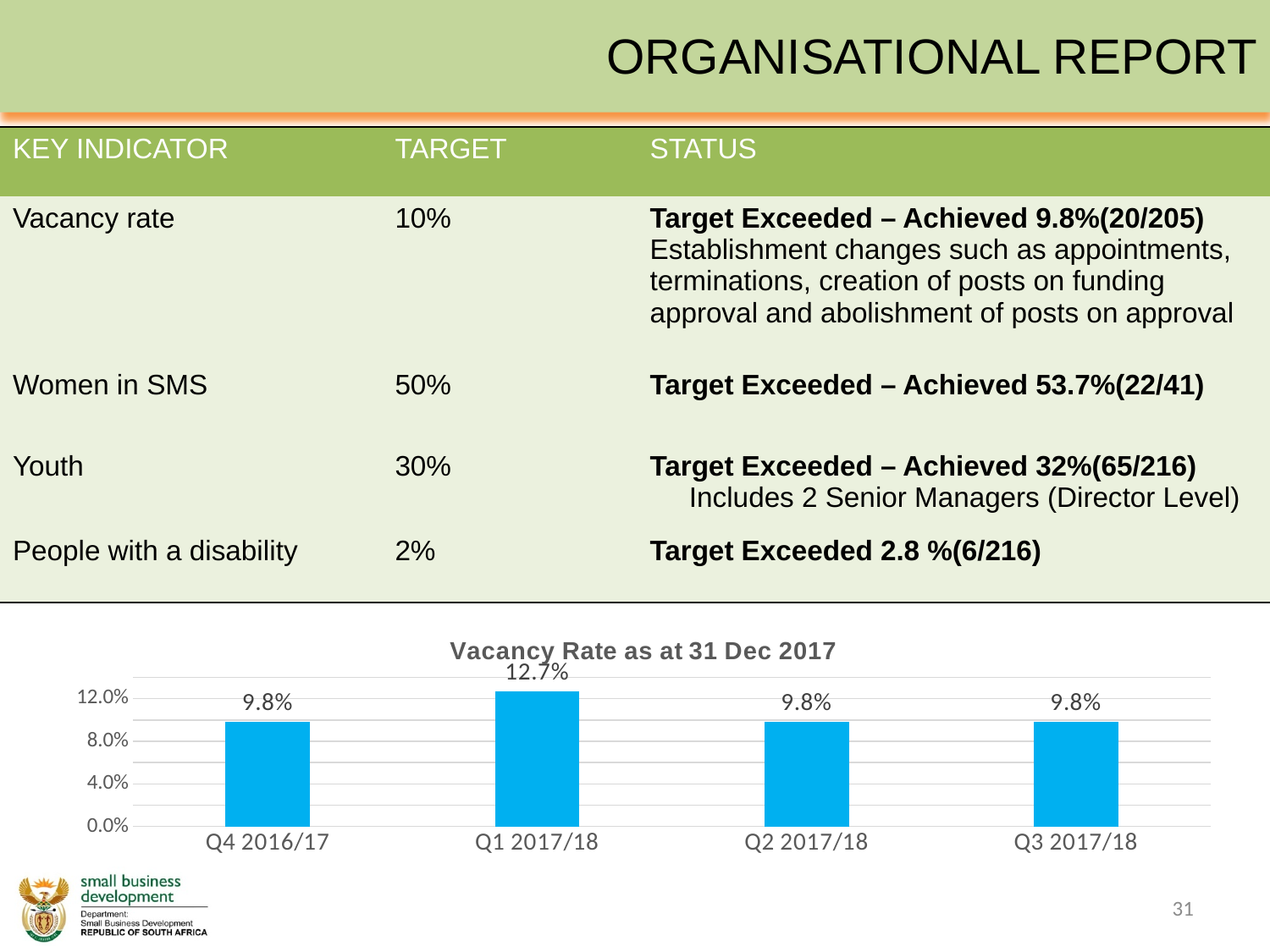
How many quarters are shown in the chart? 4 Which is larger, the vacancy rate for Q1 2017/18 or Q3 2017/18? Q1 2017/18 Is the vacancy rate for Q2 2017/18 greater or less than 12.0%? less What is the vacancy rate for Q4 2016/17? 9.8% What is the difference between the vacancy rate in Q1 2017/18 and Q2 2017/18? 2.9% Which quarter has the highest vacancy rate? Q1 2017/18 Does the vacancy rate rise or fall from Q1 2017/18 to Q2 2017/18? fall What is the title of the chart? Vacancy Rate as at 31 Dec 2017 What is the vacancy rate for Q3 2017/18? 9.8% What is the vacancy rate for Q1 2017/18? 12.7% What kind of chart is shown on the slide? bar chart Is the vacancy rate for Q1 2017/18 greater or less than 12.0%? greater